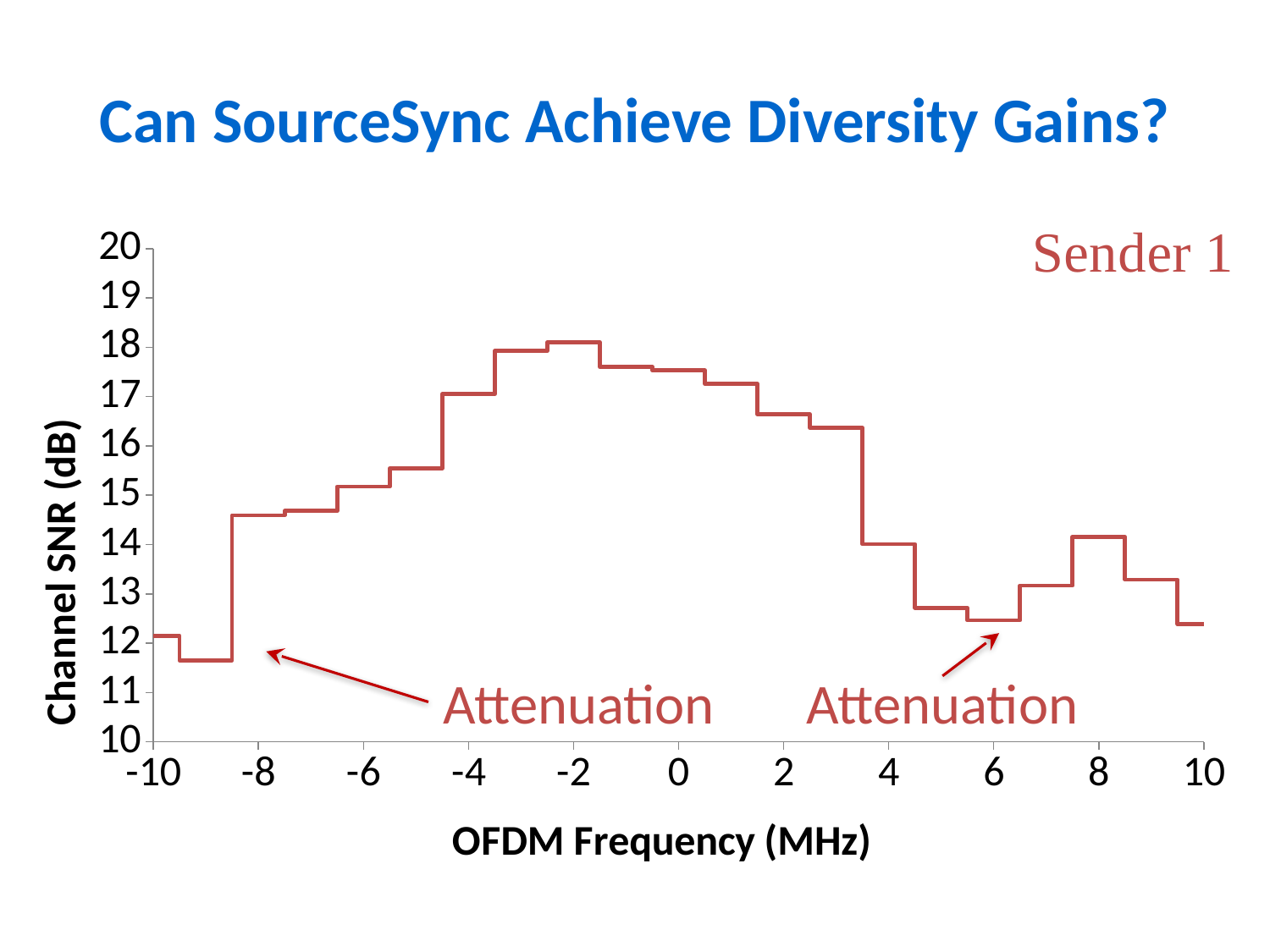
Is the Channel SNR at an OFDM frequency of -2 MHz greater or less than 17 dB? greater Is the Channel SNR at an OFDM frequency of -4 MHz greater or less than 16 dB? greater Does the Channel SNR rise or fall as the OFDM frequency increases from -8 MHz to -2 MHz? rise Is the Channel SNR at an OFDM frequency of 4 MHz greater or less than 15 dB? less What is the label of the y axis of the chart? Channel SNR (dB) Which has the higher Channel SNR: the OFDM frequency of -2 MHz or 6 MHz? -2 MHz Does the Channel SNR rise or fall as the OFDM frequency increases from 0 MHz to 6 MHz? fall Which has the higher Channel SNR: the OFDM frequency of -9 MHz or 8 MHz? 8 MHz What is the title of the slide containing the chart? Can SourceSync Achieve Diversity Gains? What kind of chart is shown on the slide? line chart